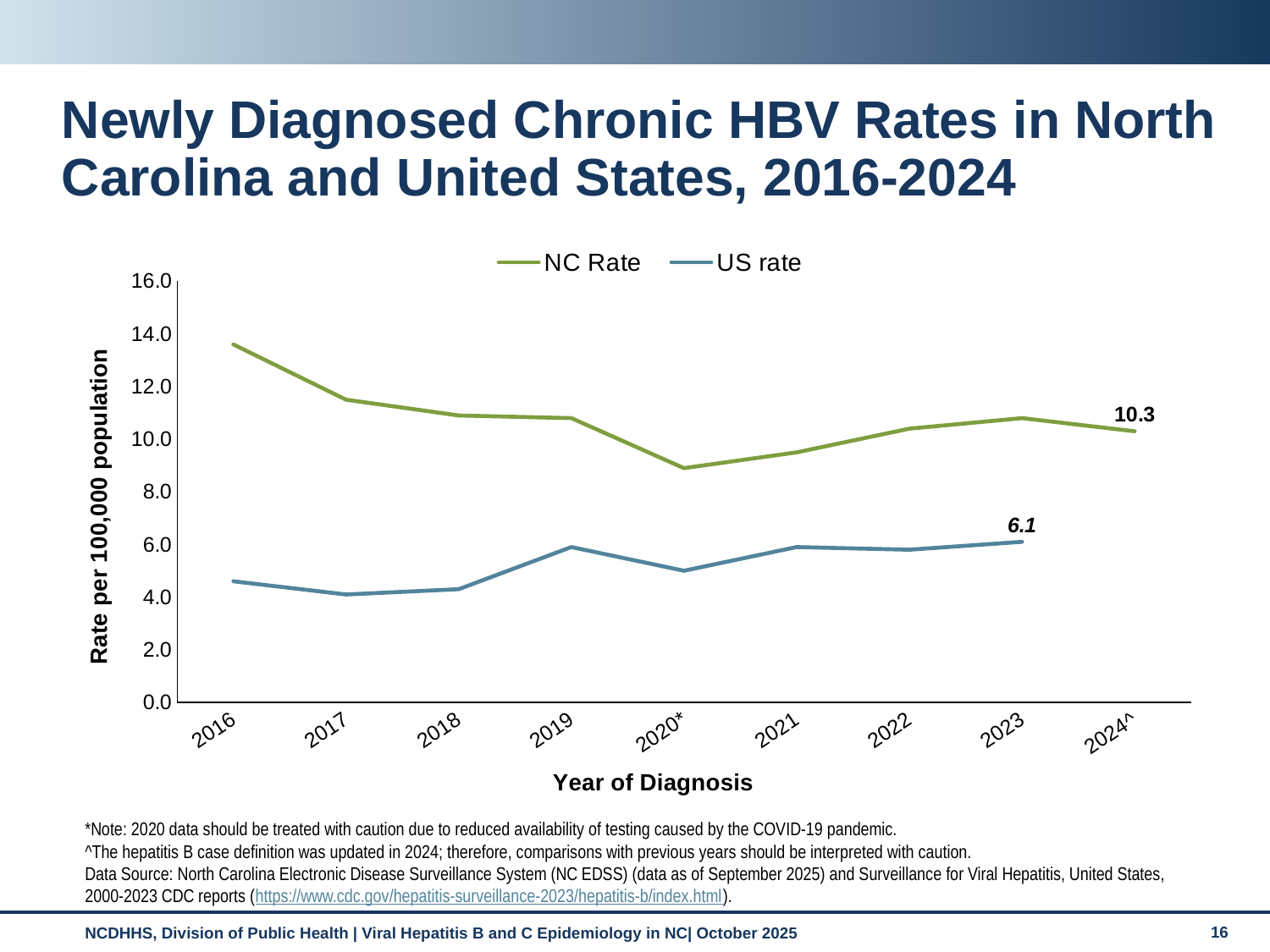
What kind of chart is shown on the slide? line chart What is the NC Rate for 2024^? 10.3 How many series does the legend list? 2 Does the NC Rate rise or fall from 2016 to 2020*? fall How many years are shown on the x axis? 9 What is the title of the y axis? Rate per 100,000 population In which year is the NC Rate lowest? 2020* In which year is the NC Rate highest? 2016 Is the US rate for 2016 greater or less than 6.0? less Is the NC Rate for 2016 greater or less than 12.0? greater Which is larger in 2016, the NC Rate or the US rate? NC Rate What is the US rate for 2023? 6.1